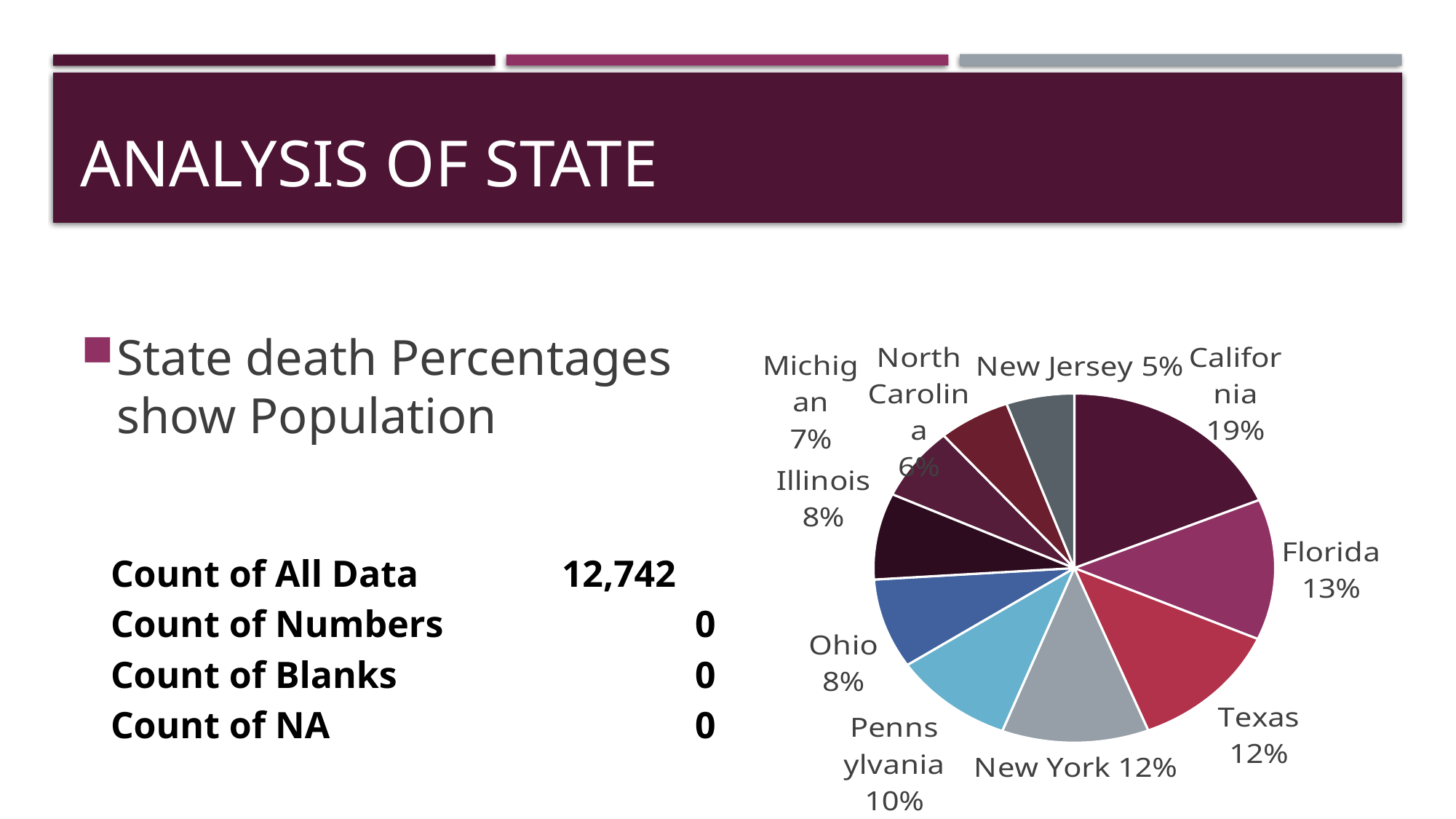
What percentage does the Ohio slice show? 8% What is the difference in percentage points between California and Florida? 6 What percentage does the New Jersey slice show? 5% What is the difference in percentage points between Pennsylvania and North Carolina? 4 Which state has the smallest slice of the pie? New Jersey What percentage does the California slice show? 19% Which state has the largest slice of the pie? California How many slices does the pie chart have? 10 Which is larger, the Michigan slice or the Illinois slice? Illinois What percentage does the Pennsylvania slice show? 10% What percentage does the Florida slice show? 13% What kind of chart is shown on the slide? pie chart